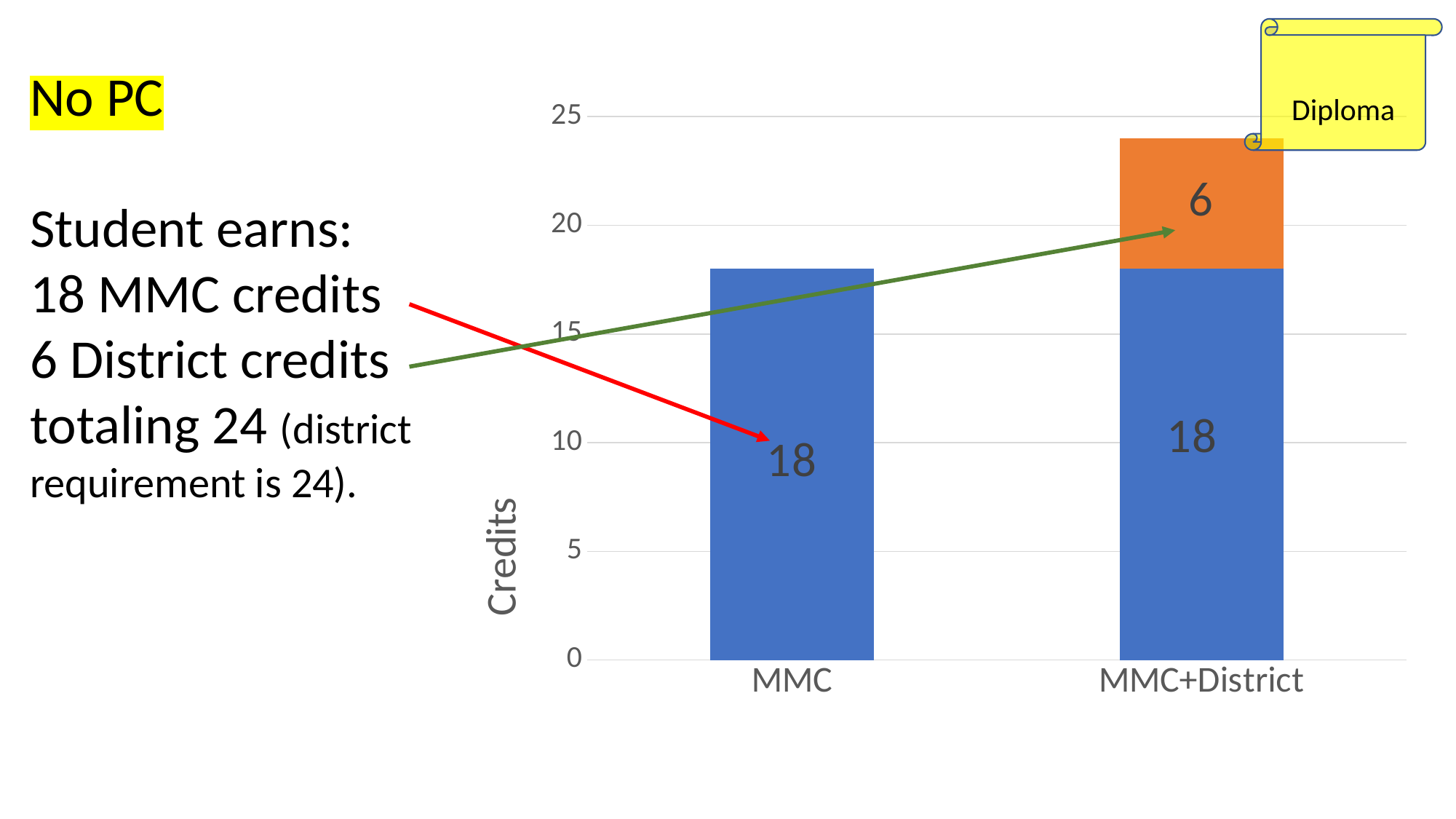
What kind of chart is shown on the slide? Stacked bar chart Which category has the taller bar, MMC or MMC+District? MMC+District What is the value of the blue segment for the MMC bar? 18 What is the highest tick value shown on the vertical axis? 25 What is the value of the blue segment in the MMC+District bar? 18 What is the value of the orange segment in the MMC+District bar? 6 What is the label of the vertical axis? Credits Is the value for MMC greater or less than 20? less How many categories are shown on the x axis? 2 Is the total of the MMC+District bar greater or less than 20? greater What is the total of the MMC+District stacked bar? 24 What is the difference between the total of the MMC+District bar and the MMC bar? 6